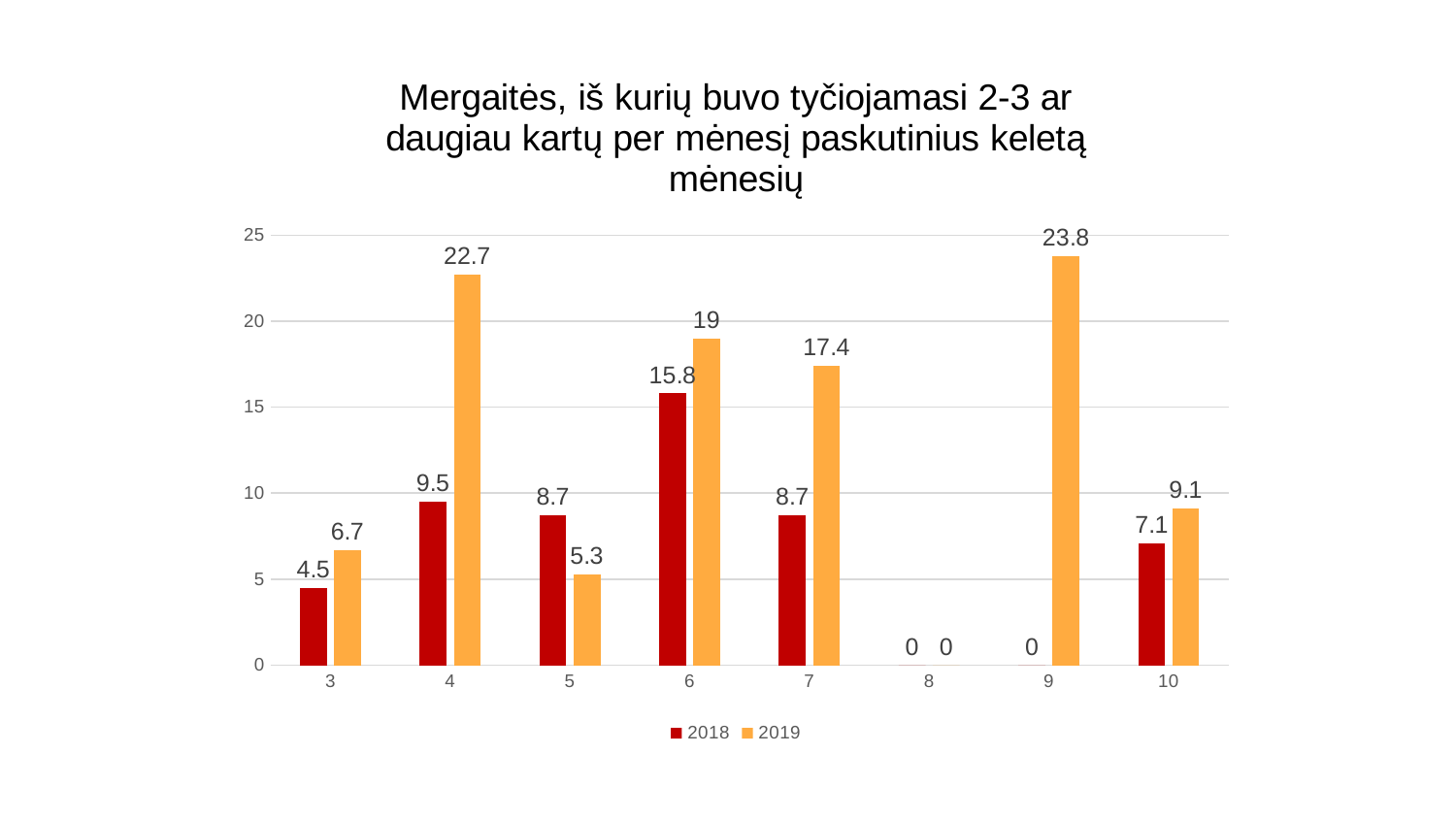
What is the 2018 value for category 6? 15.8 For category 5, which series has the larger value, 2018 or 2019? 2018 What is the 2018 value for category 10? 7.1 What kind of chart is shown on the slide? bar chart How many categories are shown on the x axis? 8 Which category has the highest 2019 value? 9 What is the difference between the 2019 values for category 9 and category 3? 17.1 How many series does the legend list? 2 What is the difference between the 2019 and 2018 values for category 4? 13.2 Which category has the highest 2018 value? 6 Which series is shown in orange? 2019 What is the 2019 value for category 4? 22.7